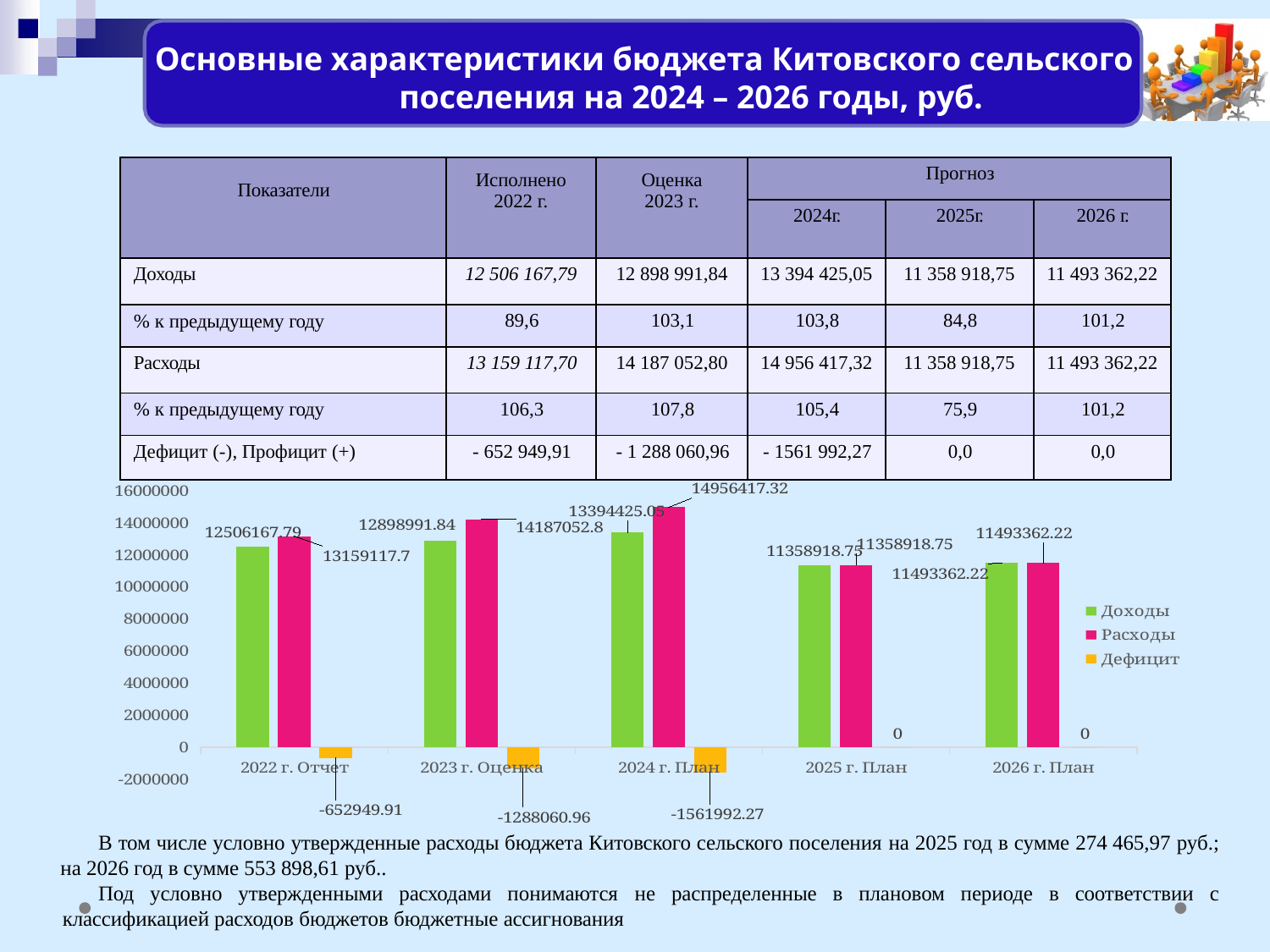
Which is larger in the chart for 2023 г. Оценка: Доходы or Расходы? Расходы Which year category has the lowest Доходы value in the chart? 2025 г. План What is the value of Дефицит for 2023 г. Оценка in the chart? -1288060.96 What is the value of Расходы for 2024 г. План in the chart? 14956417.32 Which series in the chart legend is shown in green? Доходы What kind of chart is shown on the slide? bar chart What is the difference between Расходы and Доходы for 2022 г. Отчет in the chart? 652949.91 What is the value of Дефицит for 2025 г. План in the chart? 0 Which year category has the highest Расходы value in the chart? 2024 г. План How many year categories are shown on the x axis of the chart? 5 How many series does the chart legend list? 3 What is the value of Доходы for 2022 г. Отчет in the chart? 12506167.79